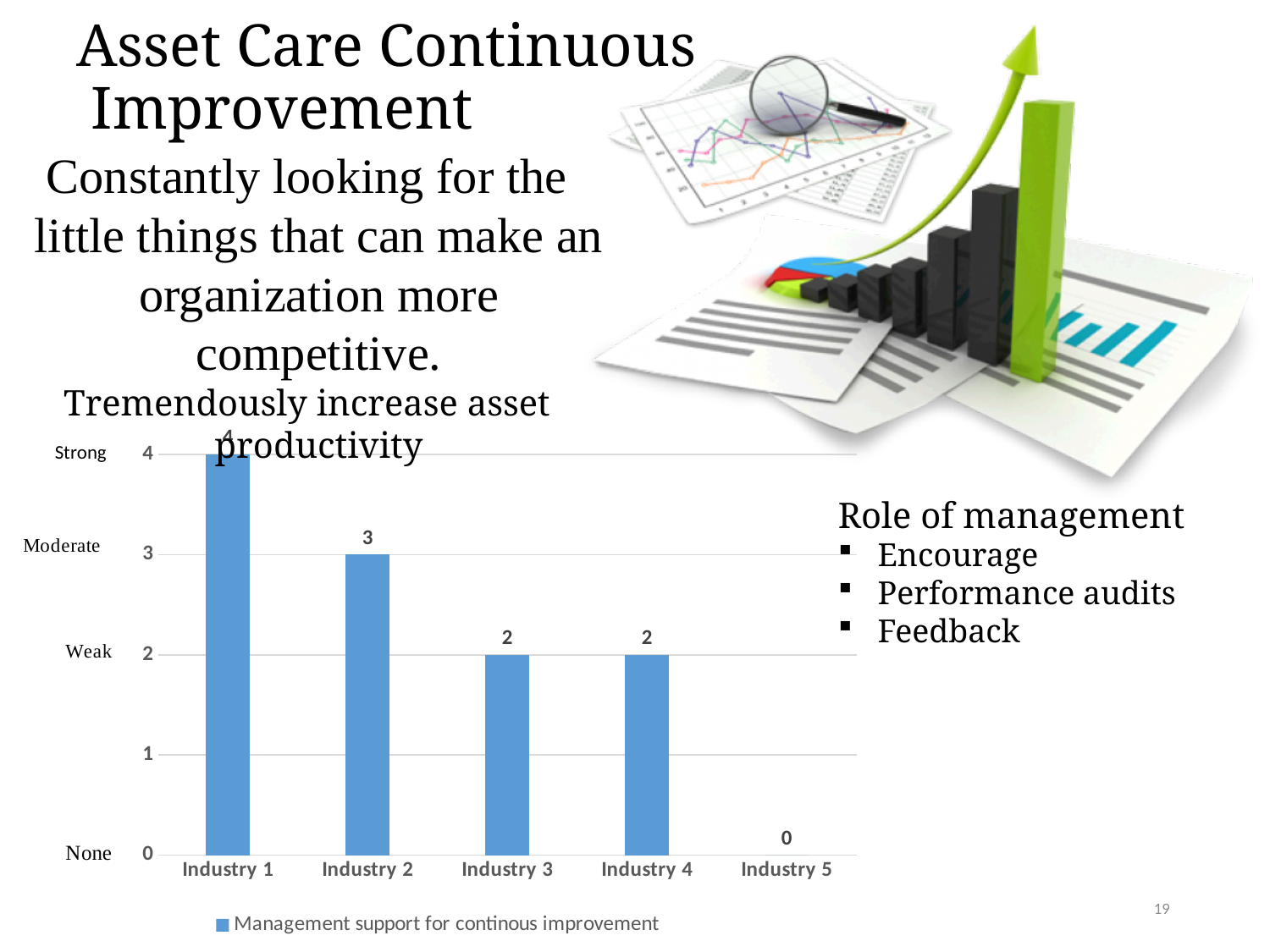
Do the values rise or fall from Industry 1 to Industry 5? fall How many series does the legend list? 1 What is the value for Industry 5? 0 Which is larger, the value for Industry 2 or the value for Industry 4? Industry 2 Which industry has the lowest value? Industry 5 What is the difference between the values for Industry 1 and Industry 3? 2 How many industries are shown on the x axis? 5 What is the value for Industry 1? 4 What is the value for Industry 2? 3 Which industry has the highest value? Industry 1 What kind of chart is shown? bar chart What series name does the legend show? Management support for continous improvement